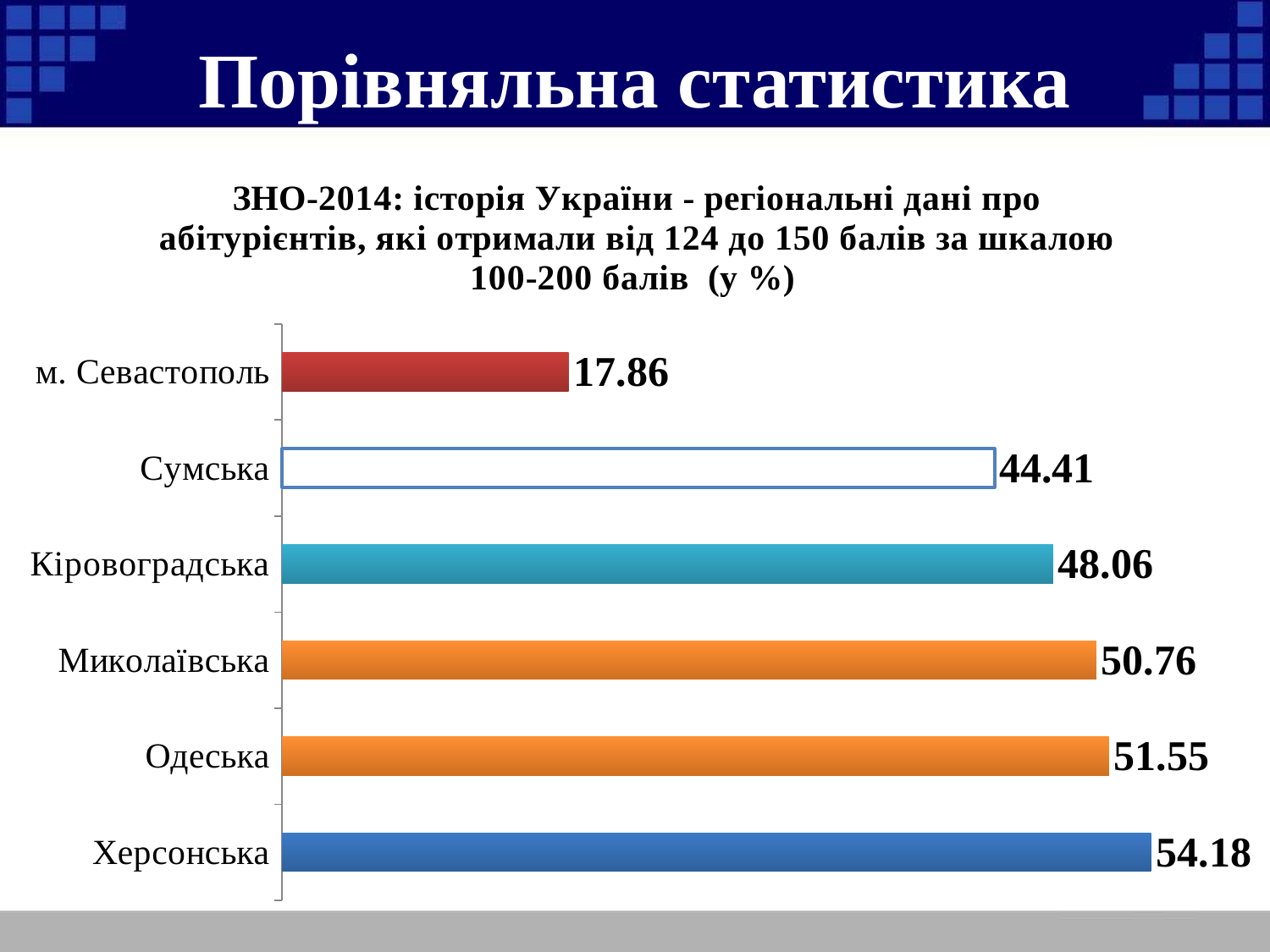
What is the value for м. Севастополь? 17.86 Which region has the highest value? Херсонська What is the difference between the values for Херсонська and м. Севастополь? 36.32 Which region has the lowest value? м. Севастополь What is the value for Сумська? 44.41 What is the value for Херсонська? 54.18 Which is larger, the value for Кіровоградська or the value for Сумська? Кіровоградська What is the value for Миколаївська? 50.76 How many regions are shown in the chart? 6 What kind of chart is shown on the slide? Bar chart Which region's bar is drawn in red? м. Севастополь What is the difference between the values for Одеська and Миколаївська? 0.79